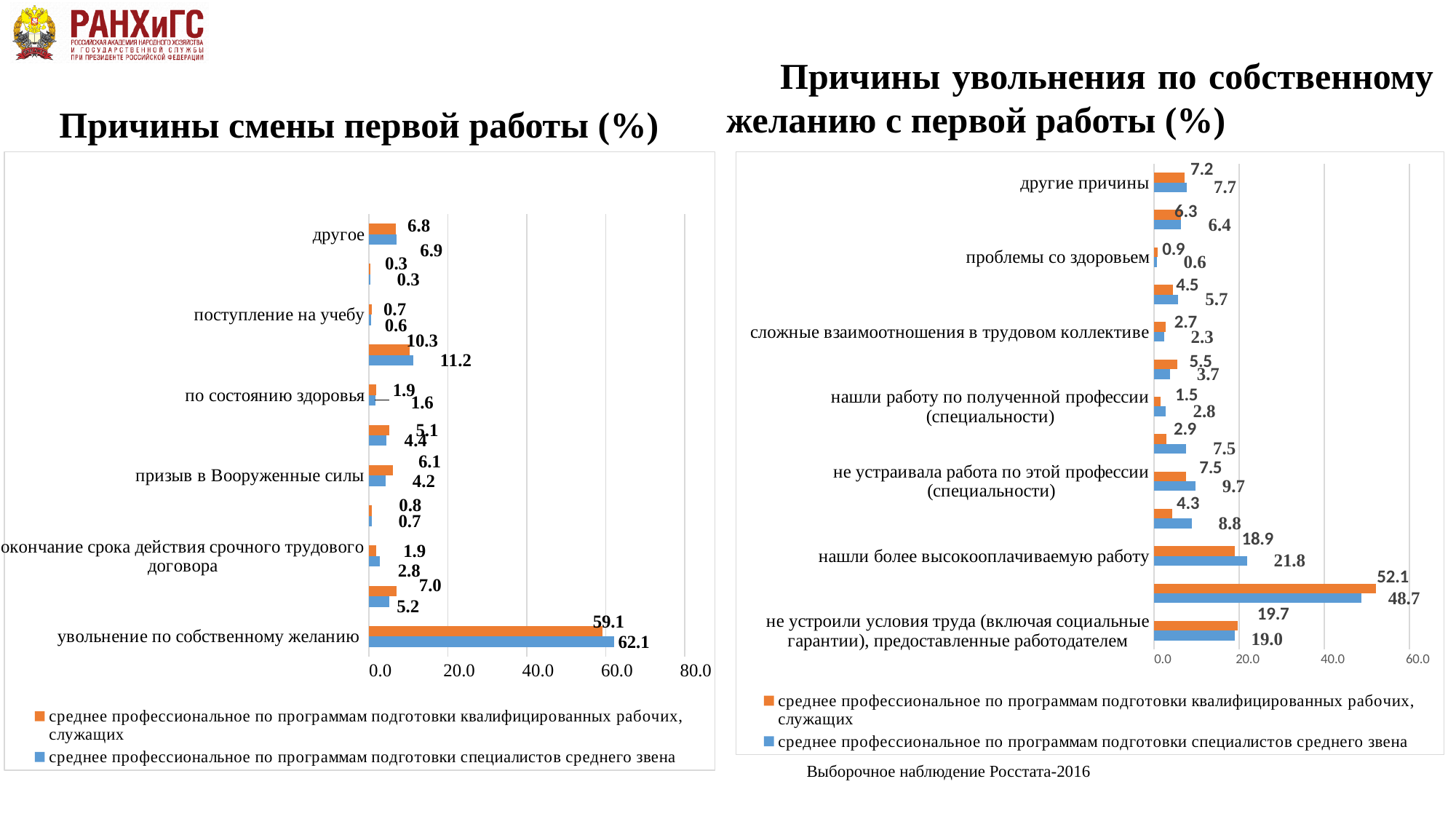
In the chart 'Причины увольнения по собственному желанию с первой работы (%)', what is the value for 'проблемы со здоровьем' for the series 'среднее профессиональное по программам подготовки квалифицированных рабочих, служащих'? 0.9 In the chart 'Причины смены первой работы (%)', which category has the highest value for both series? увольнение по собственному желанию In the chart 'Причины увольнения по собственному желанию с первой работы (%)', for 'не устроили условия труда (включая социальные гарантии), предоставленные работодателем', which series has the larger value? среднее профессиональное по программам подготовки квалифицированных рабочих, служащих In the chart 'Причины смены первой работы (%)', how many series does the legend list? 2 In the chart 'Причины смены первой работы (%)', what is the difference between the two series for 'увольнение по собственному желанию'? 3.0 In the chart 'Причины увольнения по собственному желанию с первой работы (%)', what is the difference between the two series for 'не устраивала работа по этой профессии (специальности)'? 2.2 In the chart 'Причины увольнения по собственному желанию с первой работы (%)', what is the value for 'нашли более высокооплачиваемую работу' for the series 'среднее профессиональное по программам подготовки специалистов среднего звена'? 21.8 In the chart 'Причины смены первой работы (%)', what is the value for 'увольнение по собственному желанию' for the series 'среднее профессиональное по программам подготовки специалистов среднего звена'? 62.1 In the chart 'Причины увольнения по собственному желанию с первой работы (%)', which colour represents the series 'среднее профессиональное по программам подготовки специалистов среднего звена'? blue In the chart 'Причины смены первой работы (%)', for 'окончание срока действия срочного трудового договора', which series has the larger value? среднее профессиональное по программам подготовки специалистов среднего звена In the chart 'Причины смены первой работы (%)', what is the value for 'призыв в Вооруженные силы' for the series 'среднее профессиональное по программам подготовки квалифицированных рабочих, служащих'? 6.1 What type of chart is 'Причины увольнения по собственному желанию с первой работы (%)'? bar chart